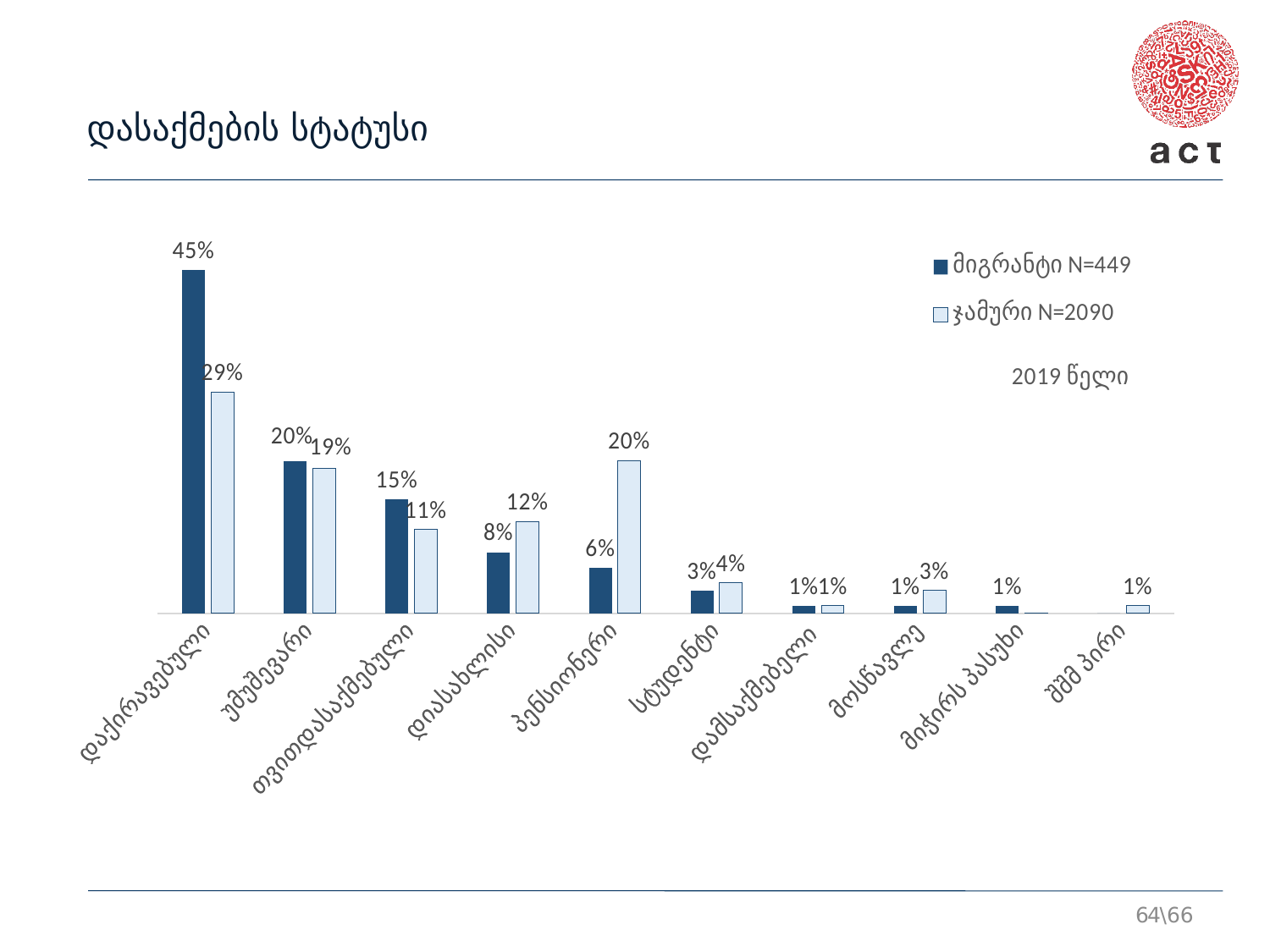
For უმუშევარი, which series has the larger value, მიგრანტი N=449 or ჯამური N=2090? მიგრანტი N=449 What type of chart is shown on the slide? Bar chart What is the value for დიასახლისი in the მიგრანტი N=449 series? 8% What is the value for თვითდასაქმებული in the ჯამური N=2090 series? 11% What is the value for დაქირავებული in the მიგრანტი N=449 series? 45% What is the difference between the ჯამური N=2090 and მიგრანტი N=449 values for პენსიონერი? 14% How many series does the legend list? 2 Which category has the highest value in the მიგრანტი N=449 series? დაქირავებული What is the difference between the მიგრანტი N=449 and ჯამური N=2090 values for დაქირავებული? 16% How many categories are shown on the x axis of the chart? 10 What is the value for პენსიონერი in the ჯამური N=2090 series? 20% For დიასახლისი, which series has the larger value, მიგრანტი N=449 or ჯამური N=2090? ჯამური N=2090